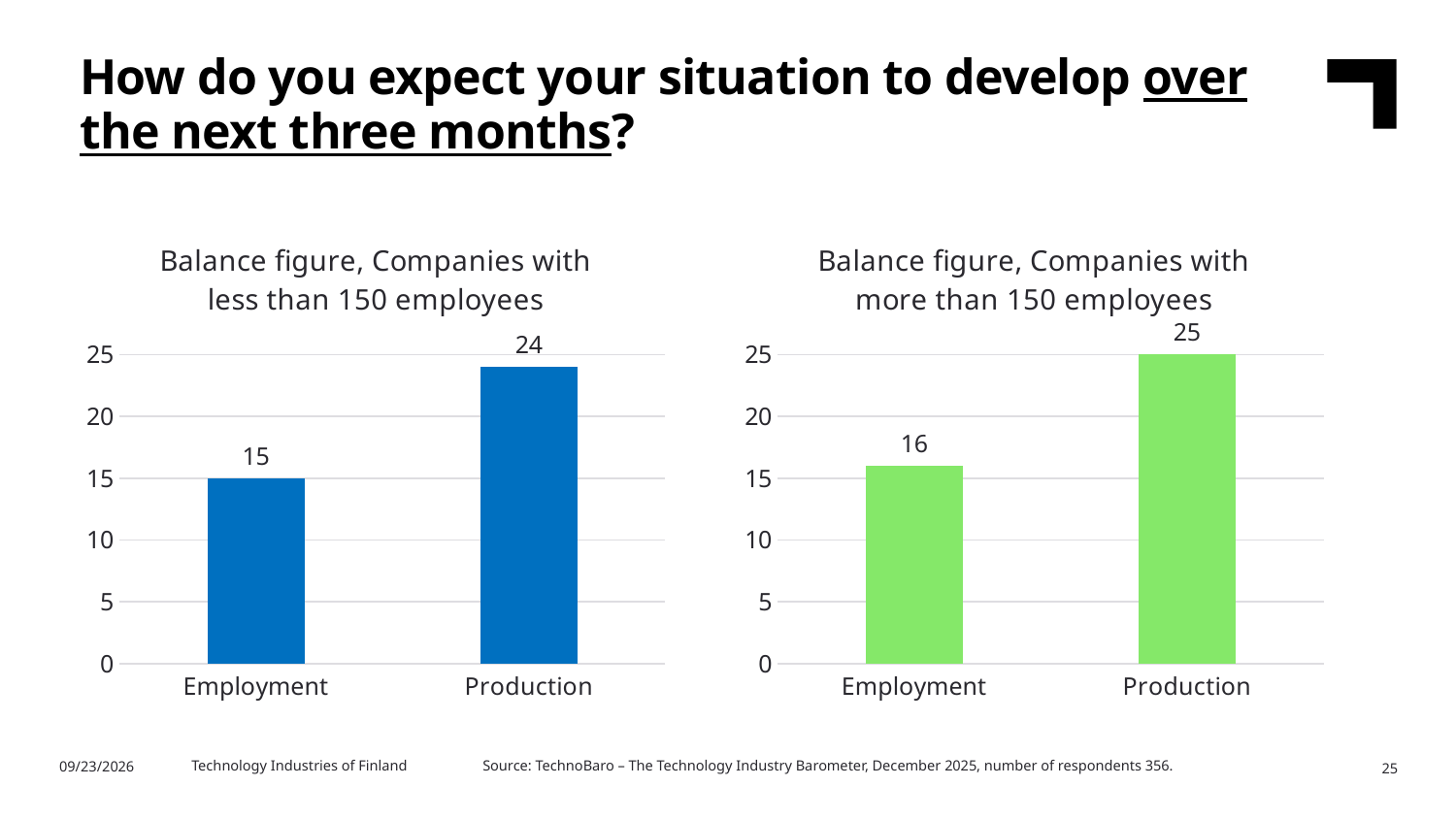
In the chart 'Balance figure, Companies with more than 150 employees', what is the value for Employment? 16 In the chart 'Balance figure, Companies with more than 150 employees', which is larger, the value for Employment or the value for Production? Production What kind of chart is the chart on the right of the slide? Bar chart In the chart 'Balance figure, Companies with less than 150 employees', which category has the highest value? Production In the chart 'Balance figure, Companies with more than 150 employees', which category has the lowest value? Employment In the chart 'Balance figure, Companies with more than 150 employees', what is the difference between the values for Production and Employment? 9 What colour are the bars in the chart 'Balance figure, Companies with more than 150 employees'? Green How many categories are shown in the chart 'Balance figure, Companies with less than 150 employees'? 2 In the chart 'Balance figure, Companies with less than 150 employees', what is the value for Employment? 15 In the chart 'Balance figure, Companies with less than 150 employees', what is the difference between the values for Production and Employment? 9 In the chart 'Balance figure, Companies with more than 150 employees', what is the value for Production? 25 In the chart 'Balance figure, Companies with less than 150 employees', what is the value for Production? 24